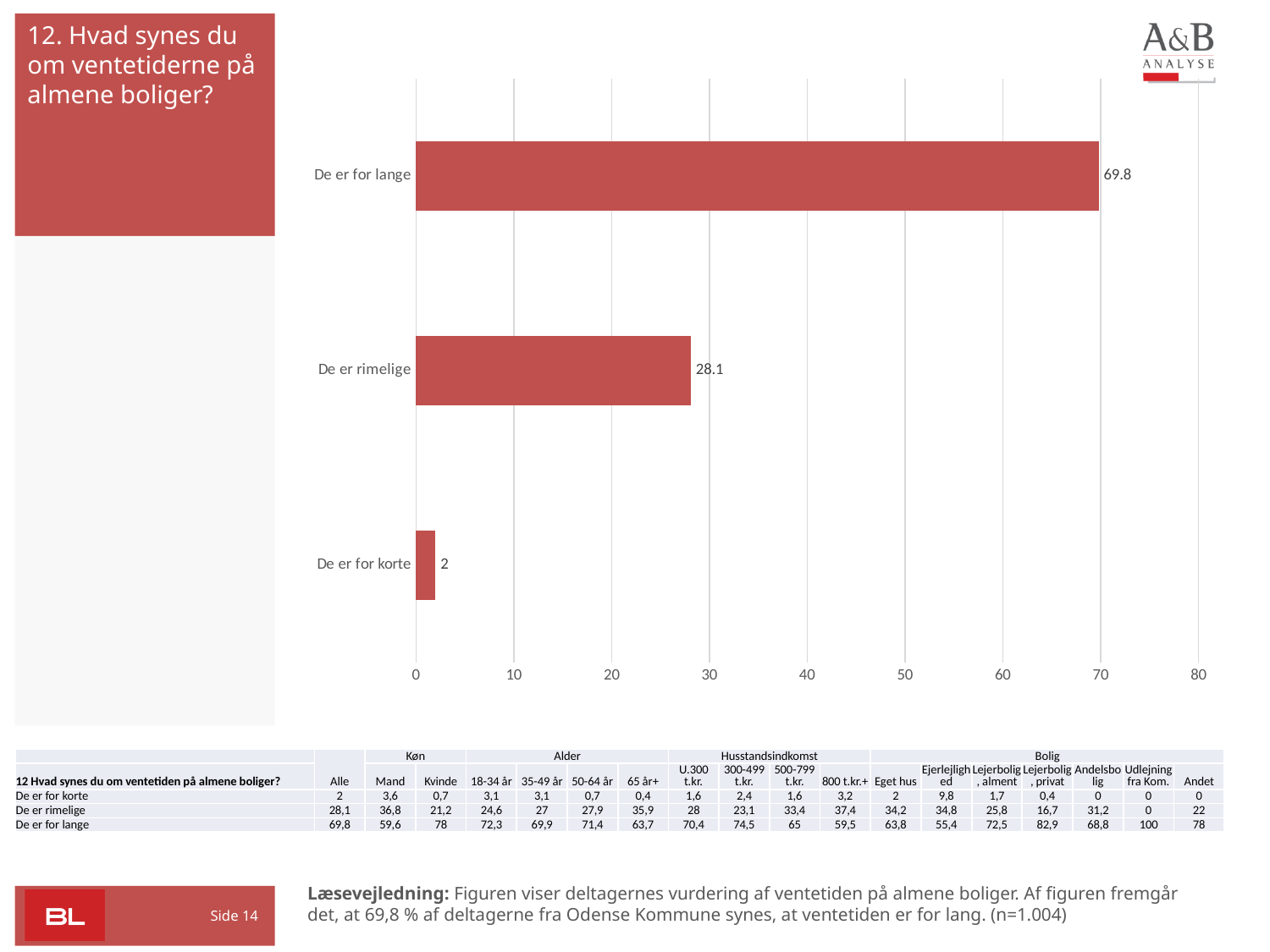
What is the difference between the values for "De er for lange" and "De er rimelige"? 41.7 What is the value for "De er for korte"? 2 Which category has the highest value? De er for lange What is the value for "De er for lange"? 69.8 Which category has the lowest value? De er for korte How many categories are shown in the chart? 3 What kind of chart is shown on the slide? Bar chart What is the value for "De er rimelige"? 28.1 Is the value for "De er for lange" greater or less than 60? greater Which is larger, the value for "De er rimelige" or the value for "De er for korte"? De er rimelige What is the difference between the values for "De er rimelige" and "De er for korte"? 26.1 Is the value for "De er rimelige" greater or less than 30? less